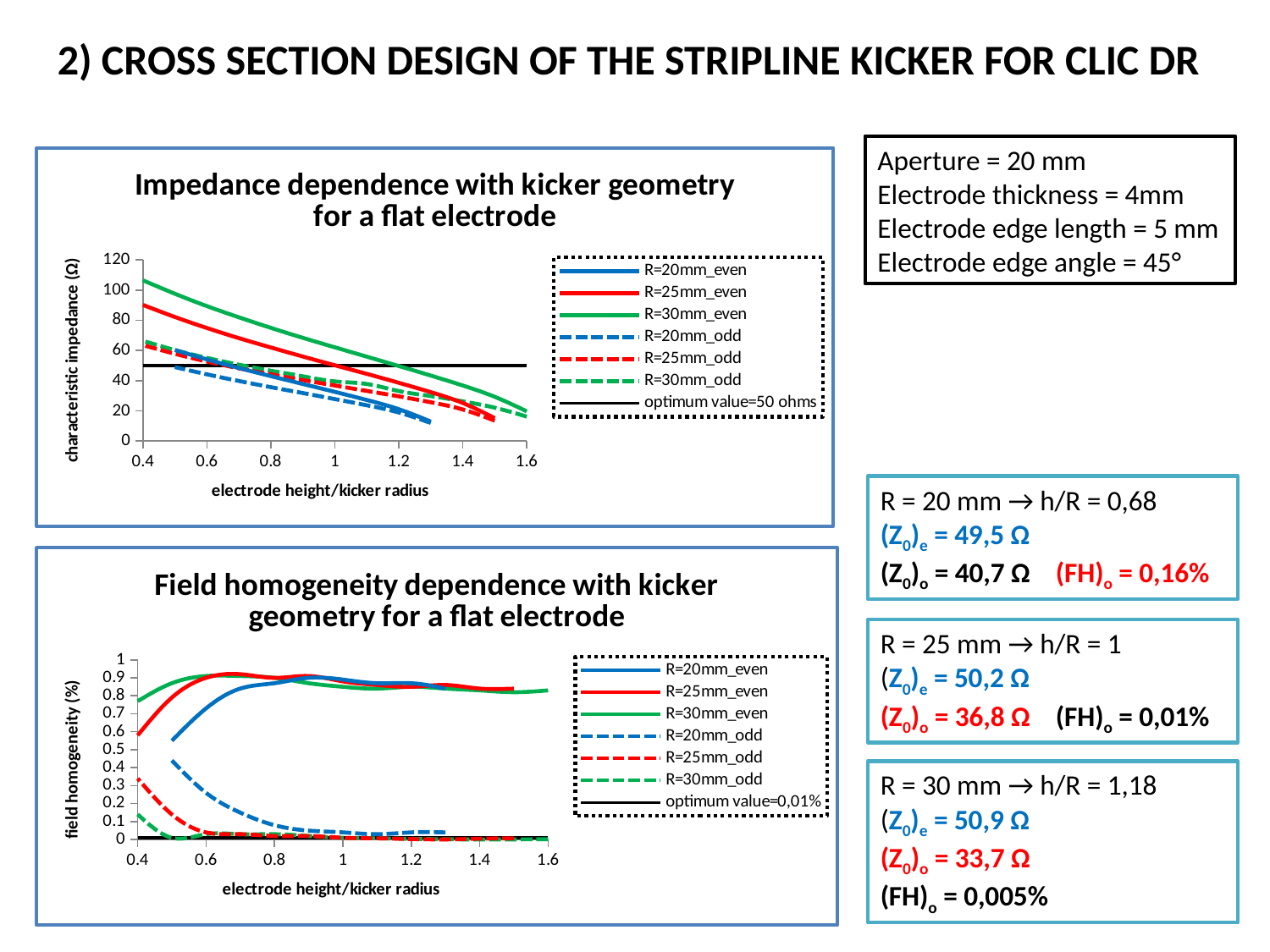
In the 'Impedance dependence with kicker geometry for a flat electrode' chart, is the value of R=25mm_even at electrode height/kicker radius 0.4 greater or less than 80? greater How many series does the legend of the 'Impedance dependence with kicker geometry for a flat electrode' chart list? 7 In the 'Field homogeneity dependence with kicker geometry for a flat electrode' chart, is the value of R=30mm_even at electrode height/kicker radius 0.4 greater or less than 0.7? greater In the 'Impedance dependence with kicker geometry for a flat electrode' chart, do the R=30mm_even values rise or fall as electrode height/kicker radius increases? fall How many series does the legend of the 'Field homogeneity dependence with kicker geometry for a flat electrode' chart list? 7 What is the label of the x axis of the 'Field homogeneity dependence with kicker geometry for a flat electrode' chart? electrode height/kicker radius In the 'Impedance dependence with kicker geometry for a flat electrode' chart, at electrode height/kicker radius 0.8, which is larger: R=30mm_even or R=20mm_even? R=30mm_even In the 'Impedance dependence with kicker geometry for a flat electrode' chart, which series has the highest value at electrode height/kicker radius 0.4? R=30mm_even In the 'Impedance dependence with kicker geometry for a flat electrode' chart, is the value of R=30mm_even at electrode height/kicker radius 0.4 greater or less than 100? greater In the 'Field homogeneity dependence with kicker geometry for a flat electrode' chart, do the R=20mm_odd values rise or fall as electrode height/kicker radius increases from 0.5 to 1? fall What type of chart is the 'Impedance dependence with kicker geometry for a flat electrode' chart? line chart What value does the horizontal black line in the 'Impedance dependence with kicker geometry for a flat electrode' chart represent, according to the legend? optimum value=50 ohms